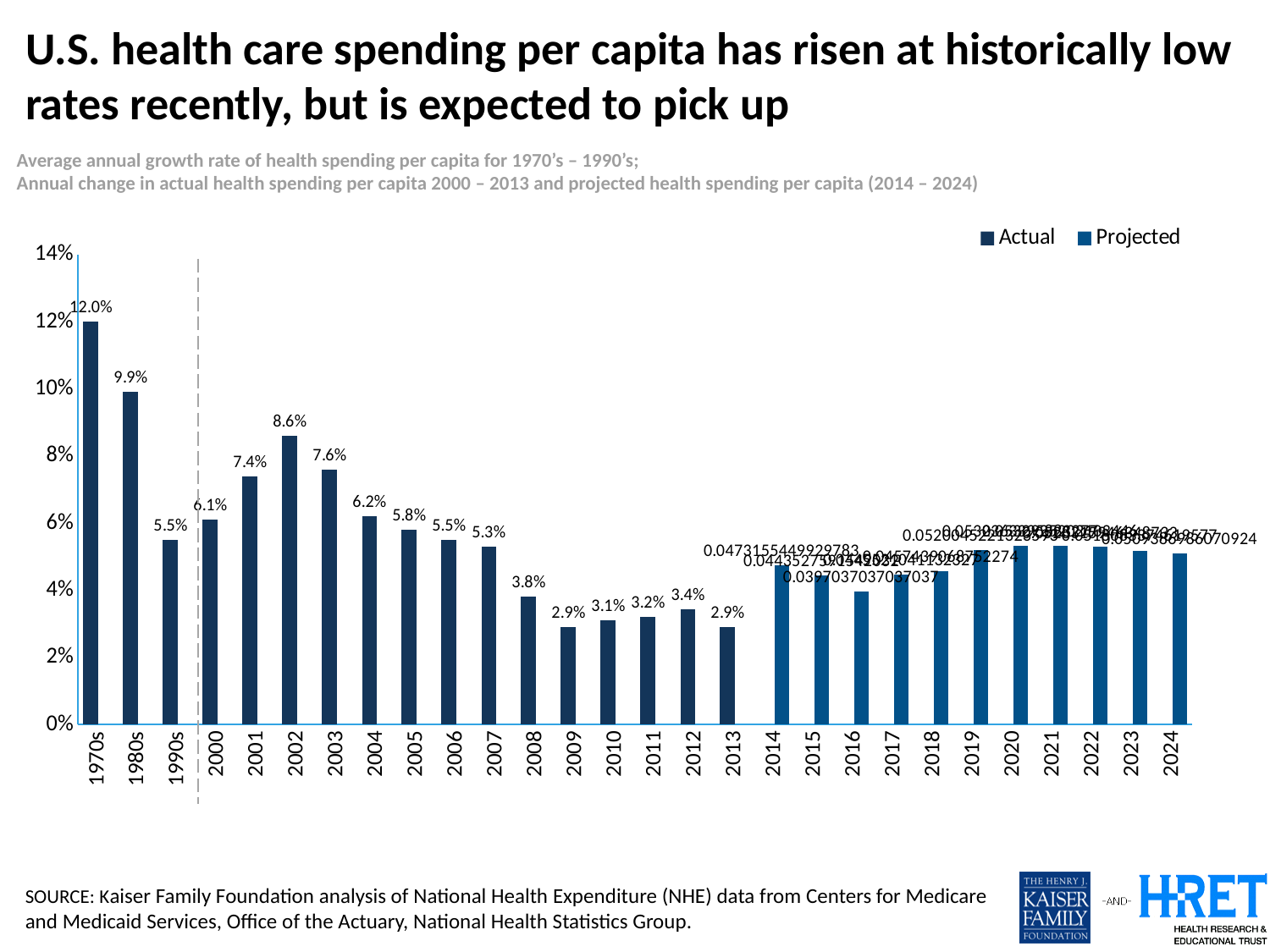
What kind of chart is shown on the slide? Bar chart What is the annual change in health spending per capita shown for 2002? 8.6% Which category has the highest value on the chart? 1970s What value is shown for 2012? 3.4% Do the values rise or fall from 2002 to 2009? Fall How many categories are shown along the x axis? 28 Which is larger, the value for 2001 or the value for 2003? 2003 What value is shown for 2008? 3.8% How many series does the legend list? 2 What is the average annual growth rate shown for the 1970s? 12.0% What is the difference between the values for the 1970s and the 1980s? 2.1% Is the projected value for 2019 greater or less than 4%? greater